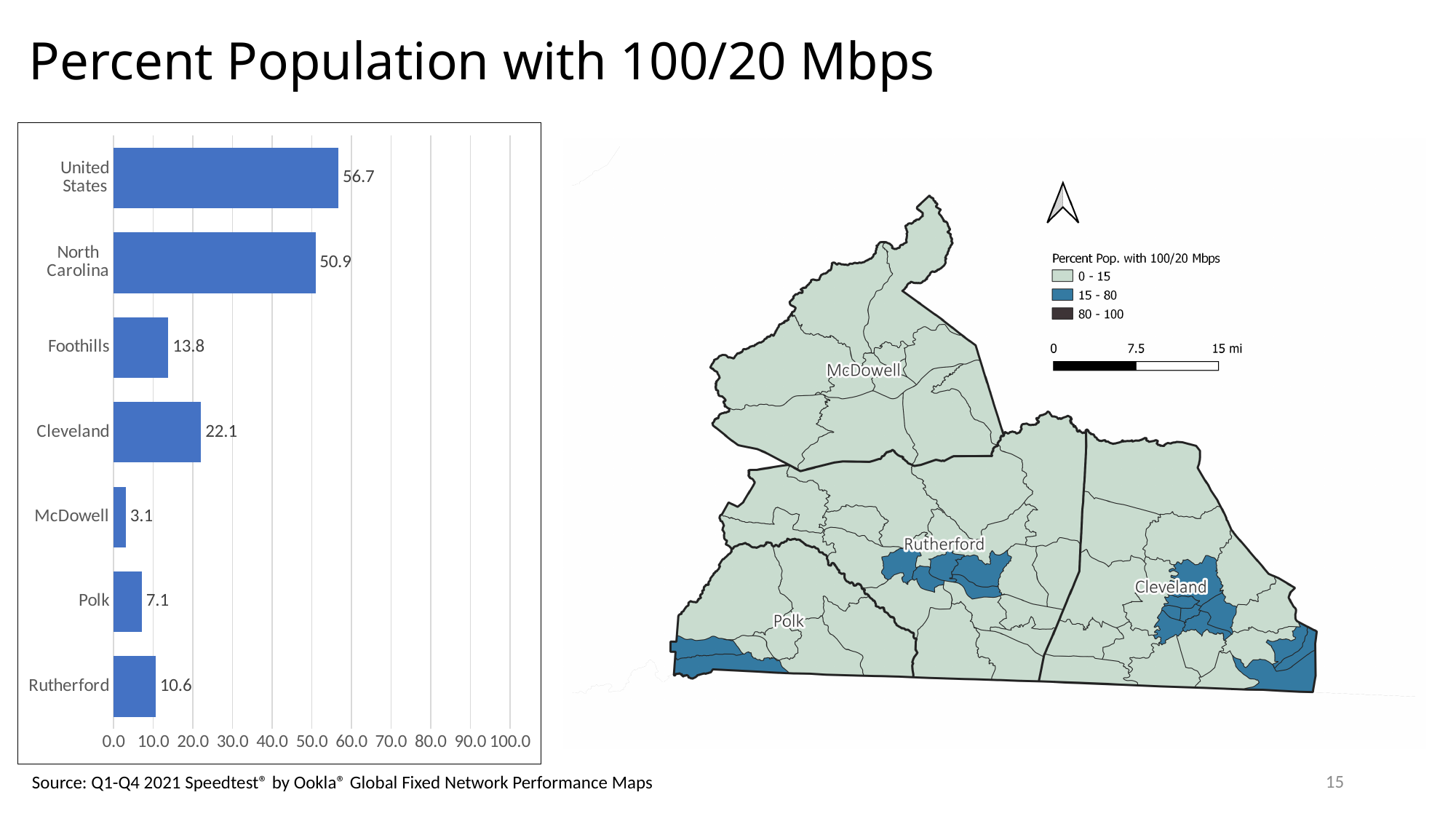
Which has a larger value in the bar chart, Foothills or Polk? Foothills What is the value for Cleveland in the bar chart? 22.1 What is the value for North Carolina in the bar chart? 50.9 What is the maximum value shown on the x axis of the bar chart? 100.0 Which category has the lowest value in the bar chart? McDowell How many categories are shown in the bar chart? 7 What kind of chart is shown on the left of the slide? Bar chart Which category has the highest value in the bar chart? United States What is the difference between the values for the United States and North Carolina in the bar chart? 5.8 What is the difference between the values for Cleveland and Rutherford in the bar chart? 11.5 What is the value for McDowell in the bar chart? 3.1 What is the value for the United States in the bar chart? 56.7